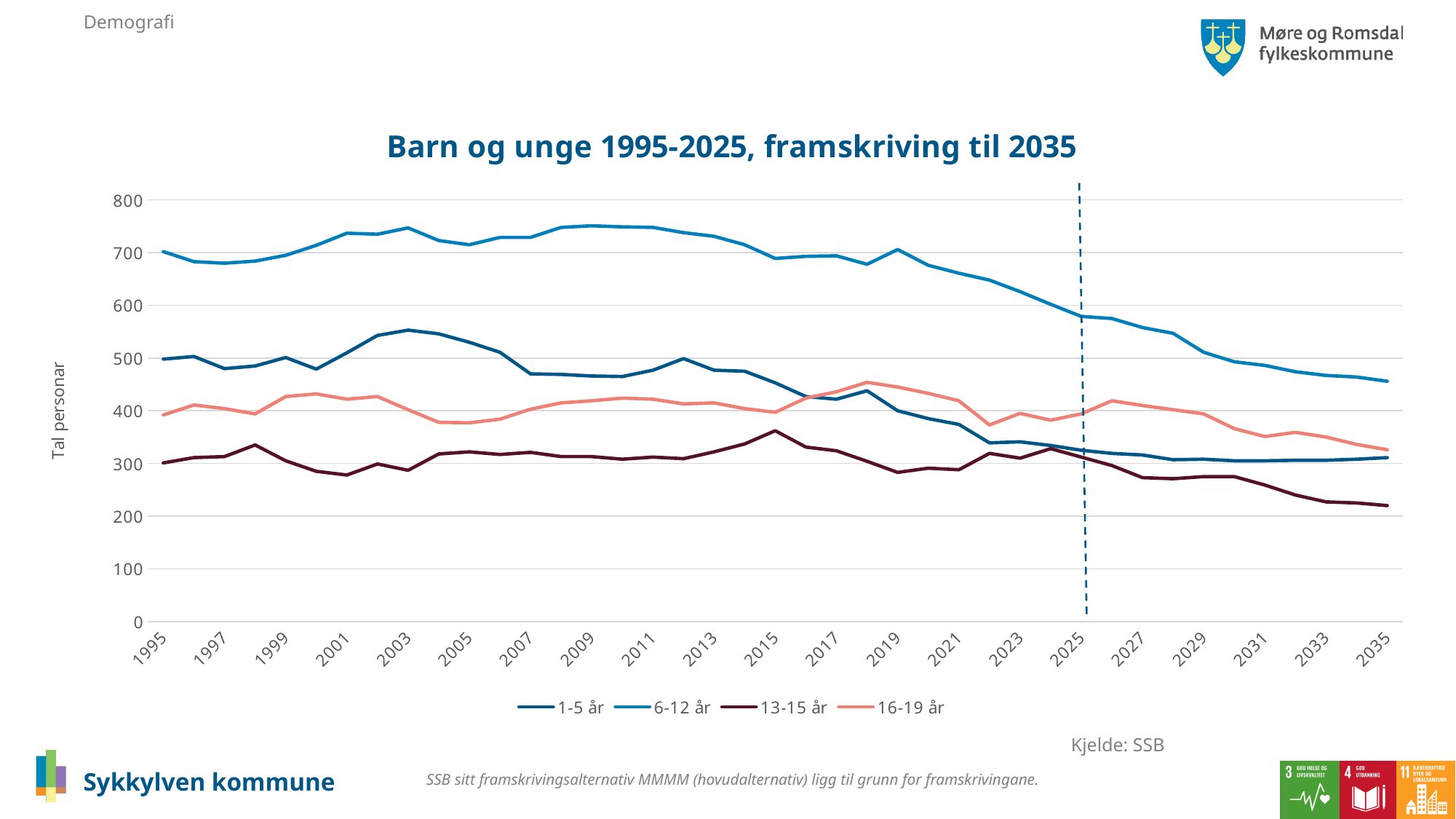
In 2011, which series is larger, 6-12 år or 1-5 år? 6-12 år Is the value for 6-12 år in 2035 greater or less than 500? less What is the title of the chart? Barn og unge 1995-2025, framskriving til 2035 Is the value for 13-15 år in 2035 greater or less than 300? less Is the value for 6-12 år in 2009 greater or less than 700? greater What kind of chart is shown on the slide? line chart Does the 6-12 år series rise or fall from 2019 to 2035? fall Which series has the lowest value in 2035? 13-15 år Which series has the highest values across the whole period? 6-12 år How many series does the legend list? 4 What is the label on the vertical axis? Tal personar